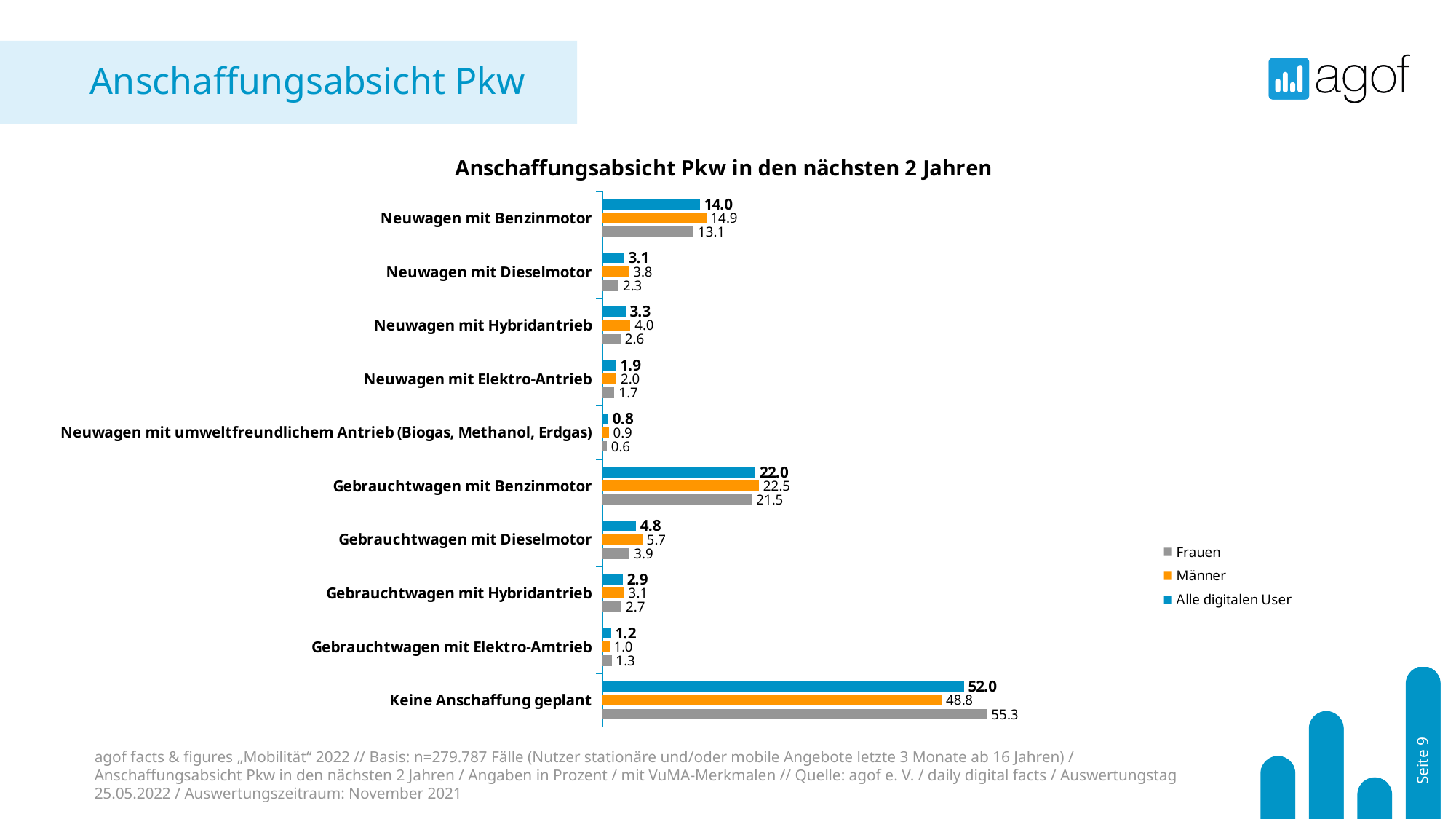
Which colour represents the "Männer" series? Orange How many series does the legend list? 3 What is the value for "Frauen" for "Keine Anschaffung geplant"? 55.3 What is the value for "Männer" for "Gebrauchtwagen mit Dieselmotor"? 5.7 How many categories are shown on the chart? 10 What is the value for "Alle digitalen User" for "Neuwagen mit Benzinmotor"? 14.0 Which category has the lowest value for "Frauen"? Neuwagen mit umweltfreundlichem Antrieb (Biogas, Methanol, Erdgas) For "Gebrauchtwagen mit Elektro-Amtrieb", which is larger: the value for "Frauen" or for "Männer"? Frauen What kind of chart is shown on the slide? Bar chart What is the difference between the "Frauen" and "Männer" values for "Keine Anschaffung geplant"? 6.5 What is the title of the chart? Anschaffungsabsicht Pkw in den nächsten 2 Jahren Which category has the highest value for "Alle digitalen User"? Keine Anschaffung geplant